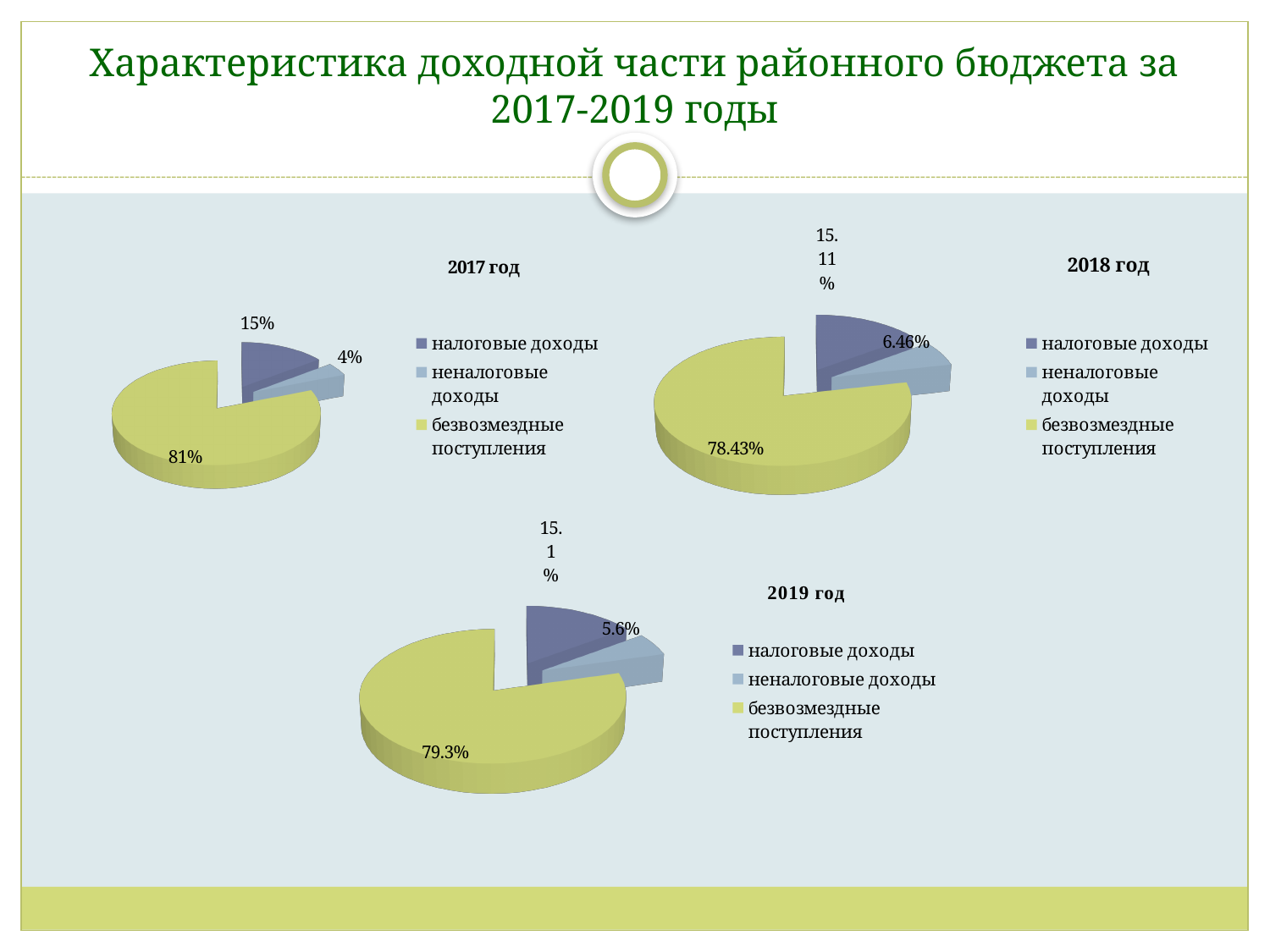
In the "2018 год" chart, which category has the largest slice? безвозмездные поступления In the "2019 год" chart, which is larger: налоговые доходы or неналоговые доходы? налоговые доходы In the "2019 год" chart, what share is shown for безвозмездные поступления? 79.3% In the "2017 год" chart, what share is shown for безвозмездные поступления? 81% What type of chart is used for the "2019 год" chart? pie chart In the "2017 год" chart, what is the difference between the shares of налоговые доходы and неналоговые доходы? 11% In the "2018 год" chart, what share is shown for налоговые доходы? 15.11% In the "2018 год" chart, what share is shown for неналоговые доходы? 6.46% In the "2017 год" chart, what share is shown for неналоговые доходы? 4% In the "2017 год" chart, which category has the smallest slice? неналоговые доходы How many entries does the legend of the "2018 год" chart list? 3 In the "2019 год" chart, what share is shown for неналоговые доходы? 5.6%